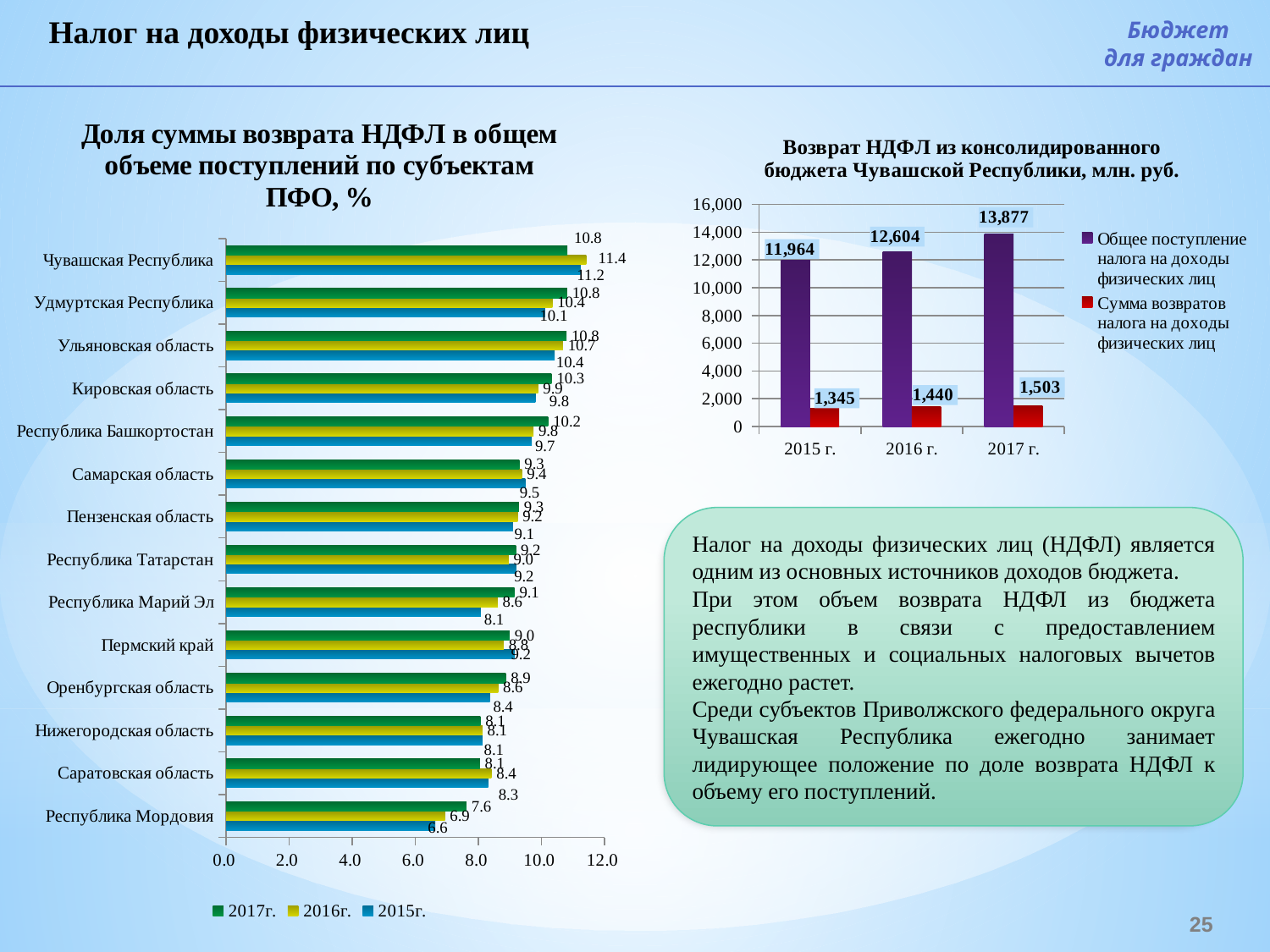
In the chart 'Доля суммы возврата НДФЛ в общем объеме поступлений по субъектам ПФО, %', what is the value for Чувашская Республика in 2016г.? 11.4 In the chart 'Возврат НДФЛ из консолидированного бюджета Чувашской Республики, млн. руб.', what type of chart is used? bar chart In the chart 'Возврат НДФЛ из консолидированного бюджета Чувашской Республики, млн. руб.', what is the value of 'Сумма возвратов налога на доходы физических лиц' for 2015 г.? 1,345 In the chart 'Доля суммы возврата НДФЛ в общем объеме поступлений по субъектам ПФО, %', how many regions are shown? 14 In the chart 'Возврат НДФЛ из консолидированного бюджета Чувашской Республики, млн. руб.', does 'Общее поступление налога на доходы физических лиц' rise or fall from 2015 г. to 2017 г.? rise In the chart 'Доля суммы возврата НДФЛ в общем объеме поступлений по субъектам ПФО, %', what is the difference between the 2017г. and 2015г. values for Республика Марий Эл? 1.0 In the chart 'Возврат НДФЛ из консолидированного бюджета Чувашской Республики, млн. руб.', by how much did 'Сумма возвратов налога на доходы физических лиц' increase from 2016 г. to 2017 г.? 63 In the chart 'Доля суммы возврата НДФЛ в общем объеме поступлений по субъектам ПФО, %', which is larger for 2017г.: Кировская область or Республика Мордовия? Кировская область In the chart 'Доля суммы возврата НДФЛ в общем объеме поступлений по субъектам ПФО, %', what is the value for Республика Мордовия in 2015г.? 6.6 In the chart 'Возврат НДФЛ из консолидированного бюджета Чувашской Республики, млн. руб.', how many series does the legend list? 2 In the chart 'Возврат НДФЛ из консолидированного бюджета Чувашской Республики, млн. руб.', what is the value of 'Общее поступление налога на доходы физических лиц' for 2017 г.? 13,877 In the chart 'Доля суммы возврата НДФЛ в общем объеме поступлений по субъектам ПФО, %', which region has the lowest value in 2017г.? Республика Мордовия